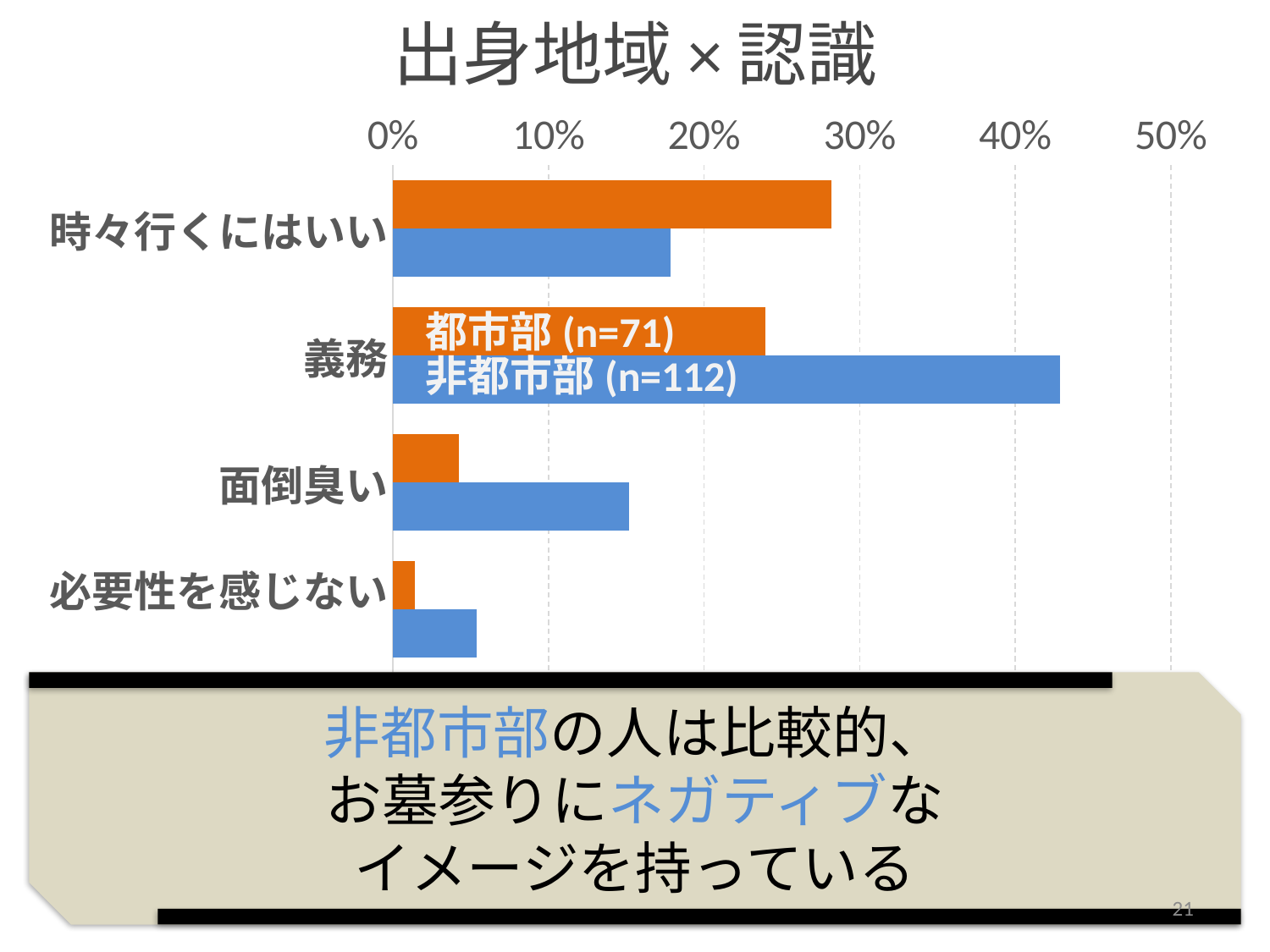
How many series does the chart show? 2 Is the value for 非都市部 (n=112) in 義務 greater or less than 40%? greater What kind of chart is shown on the slide? bar chart Is the value for 都市部 (n=71) in 面倒臭い greater or less than 10%? less How many categories are shown on the chart? 4 For 時々行くにはいい, which series has the larger value, 都市部 (n=71) or 非都市部 (n=112)? 都市部 (n=71) For the 非都市部 (n=112) series, which category has the highest value? 義務 For 義務, which series has the larger value, 都市部 (n=71) or 非都市部 (n=112)? 非都市部 (n=112) Which series is drawn in orange? 都市部 (n=71) For the 都市部 (n=71) series, which category has the highest value? 時々行くにはいい What is the title of the chart? 出身地域×認識 For the 非都市部 (n=112) series, which category has the lowest value? 必要性を感じない